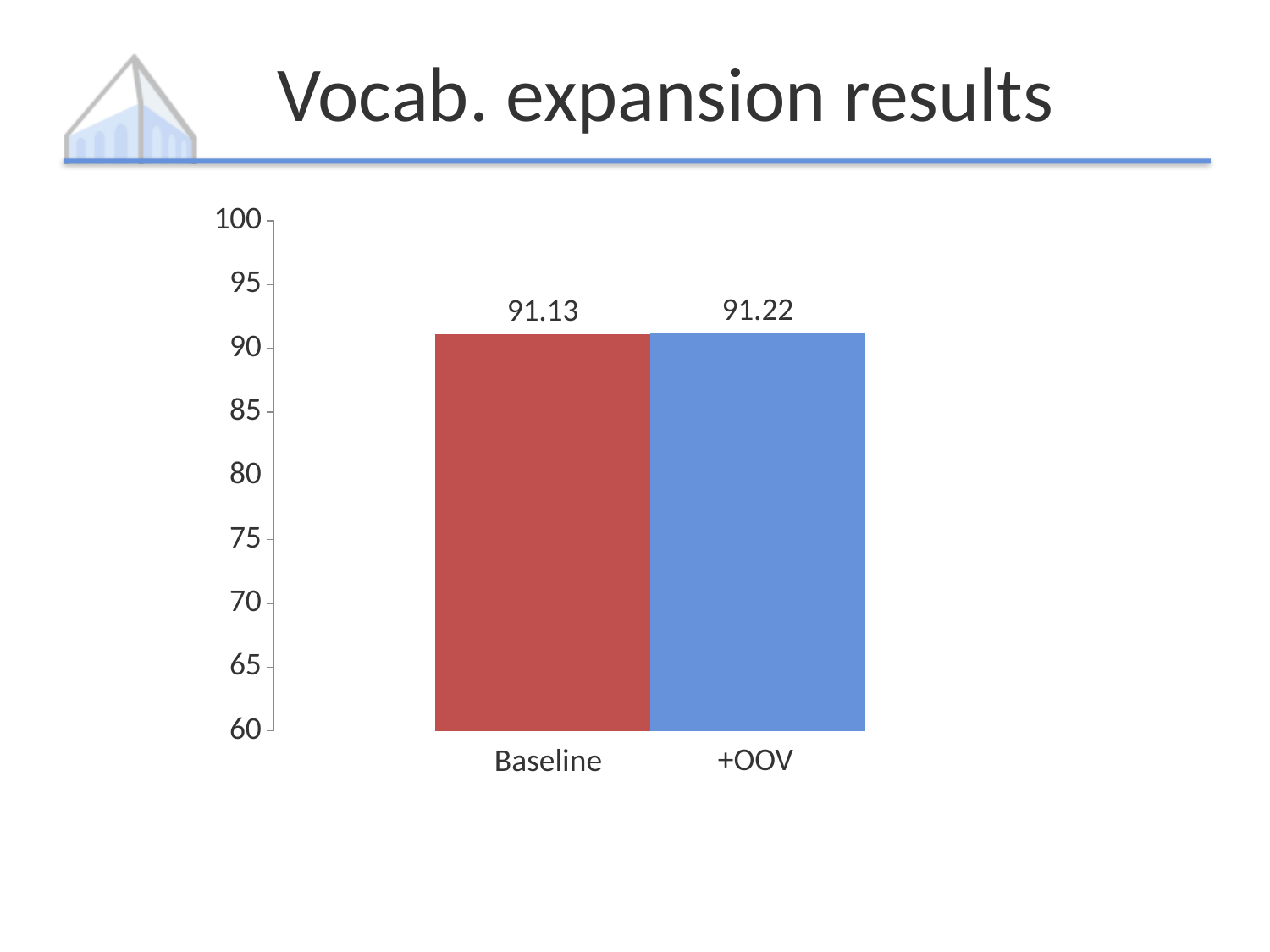
What is the value for +OOV? 91.22 Is the value for Baseline greater or less than 90? greater Which is larger, the value for Baseline or the value for +OOV? +OOV Is the value for +OOV greater or less than 95? less Do the values rise or fall from Baseline to +OOV? rise What colour is the Baseline bar? red Which category has the lowest value? Baseline How many categories are shown on the x axis? 2 What is the difference between the +OOV value and the Baseline value? 0.09 What is the value for Baseline? 91.13 Which category has the highest value? +OOV What kind of chart is shown on the slide? bar chart